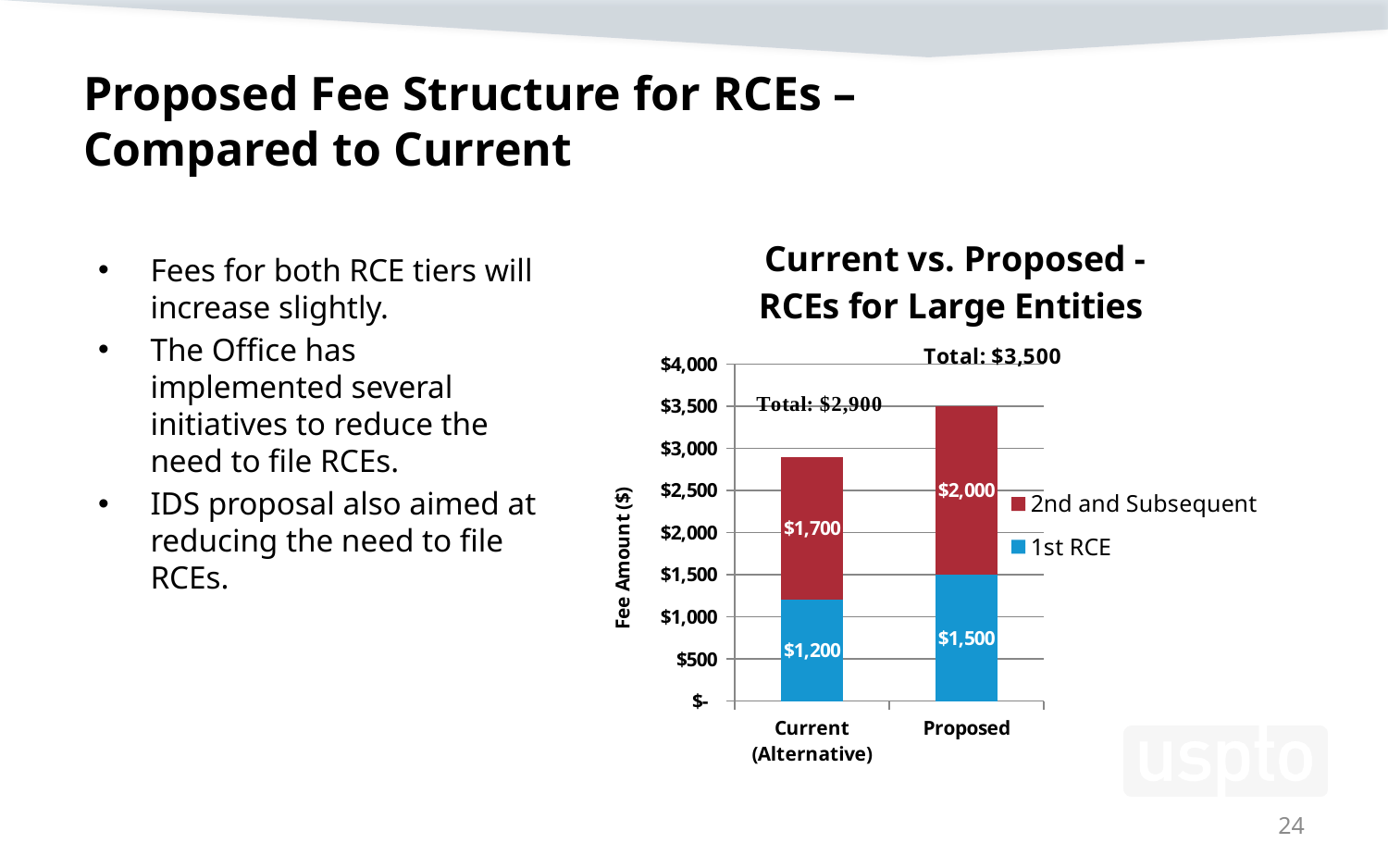
How many categories are shown on the x axis? 2 What is the total of the stacked bar for the Current (Alternative) category? $2,900 What is the 2nd and Subsequent fee for the Current (Alternative) category? $1,700 Which category has the higher 2nd and Subsequent fee, Current (Alternative) or Proposed? Proposed What is the 1st RCE fee for the Proposed category? $1,500 What kind of chart is shown on the slide? Stacked bar chart What is the title of the chart? Current vs. Proposed - RCEs for Large Entities How many series does the legend list? 2 What is the total of the stacked bar for the Proposed category? $3,500 What is the difference between the 1st RCE fee for Proposed and for Current (Alternative)? $300 What is the 1st RCE fee for the Current (Alternative) category? $1,200 What is the 2nd and Subsequent fee for the Proposed category? $2,000